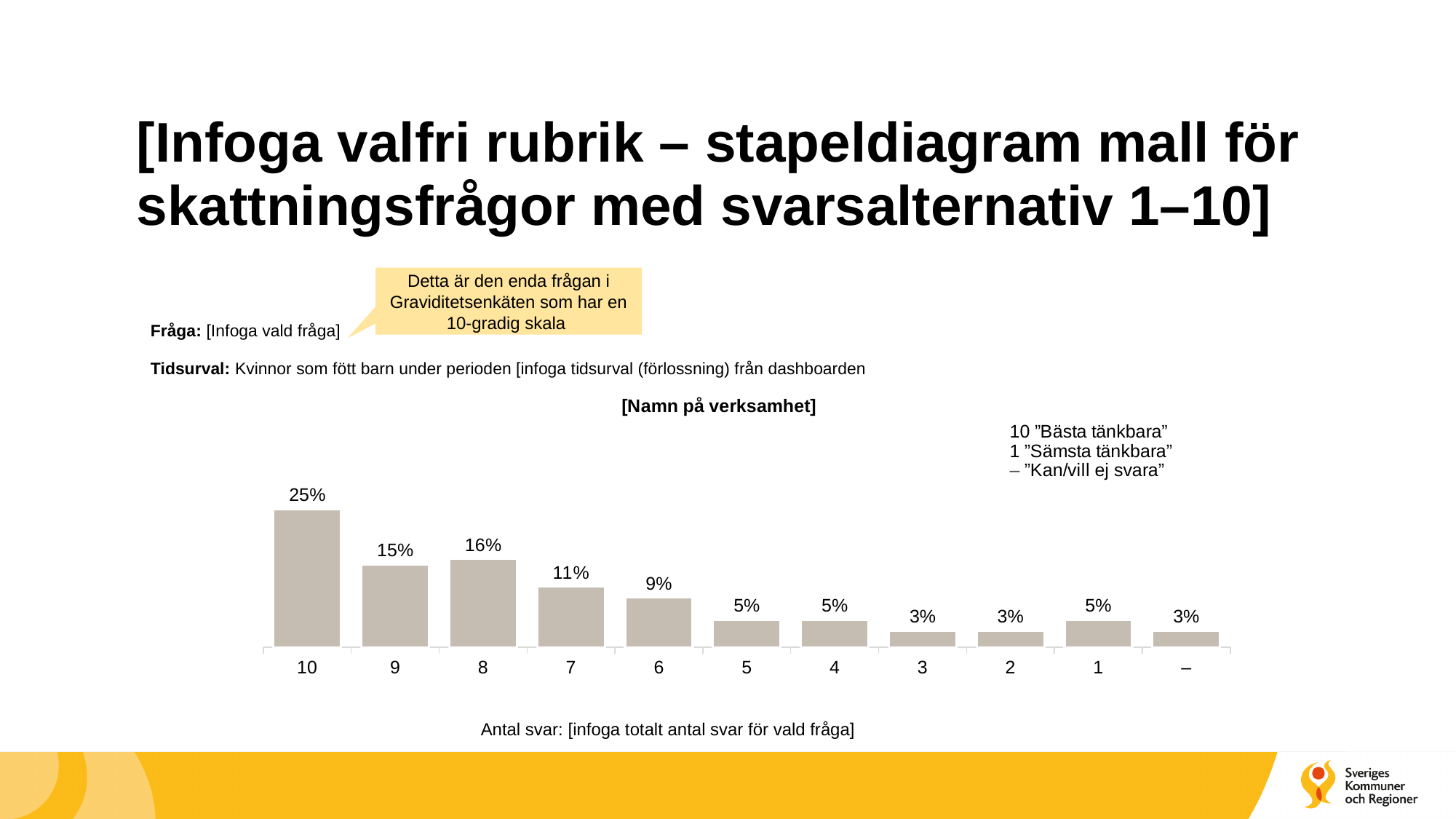
Which is larger, the value for category 6 or the value for category 5? 6 What is the title of the chart? [Namn på verksamhet] What kind of chart is shown on the slide? Bar chart Which category has the highest value? 10 What is the value for category 10? 25% How many categories are shown on the x axis? 11 What is the value for category 7? 11% What is the difference between the values for category 8 and category 7? 5% What is the value for the category labelled "–"? 3% What is the value for category 6? 9% Which is larger, the value for category 9 or the value for category 8? 8 What is the difference between the values for category 10 and category 9? 10%